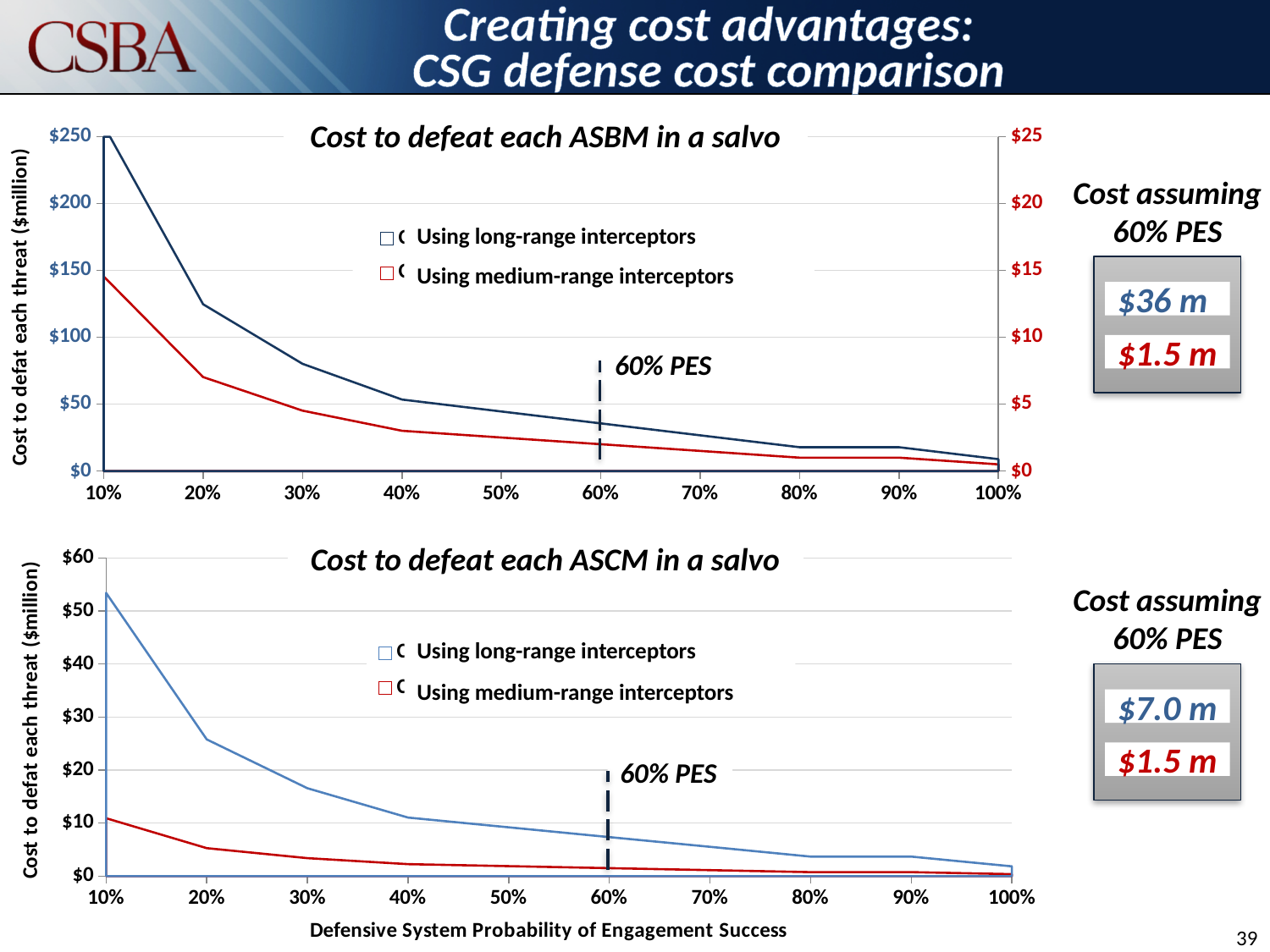
In the 'Cost to defeat each ASCM in a salvo' chart, what is the cost per threat using long-range interceptors at 60% PES? $7.0 m In the 'Cost to defeat each ASBM in a salvo' chart, what is the cost per threat using long-range interceptors at 60% PES? $36 m In the 'Cost to defeat each ASBM in a salvo' chart, what is the cost per threat using medium-range interceptors at 60% PES? $1.5 m In the 'Cost to defeat each ASBM in a salvo' chart, do the costs rise or fall as the probability of engagement success increases? fall In the 'Cost to defeat each ASCM in a salvo' chart, is the value for long-range interceptors at 30% greater or less than $20? less In the 'Cost to defeat each ASCM in a salvo' chart, what is the cost per threat using medium-range interceptors at 60% PES? $1.5 m How many series does the legend of the 'Cost to defeat each ASCM in a salvo' chart list? 2 In the 'Cost to defeat each ASCM in a salvo' chart, is the value for long-range interceptors at 10% greater or less than $50? greater In the 'Cost to defeat each ASCM in a salvo' chart, which is larger at 60% PES: the cost using long-range interceptors or using medium-range interceptors? Using long-range interceptors In the 'Cost to defeat each ASCM in a salvo' chart, what is the difference between the long-range and medium-range interceptor costs at 60% PES? $5.5 m In the 'Cost to defeat each ASBM in a salvo' chart, is the value for long-range interceptors at 20% greater or less than $100? greater In the 'Cost to defeat each ASBM in a salvo' chart, what is the difference between the long-range and medium-range interceptor costs at 60% PES? $34.5 m